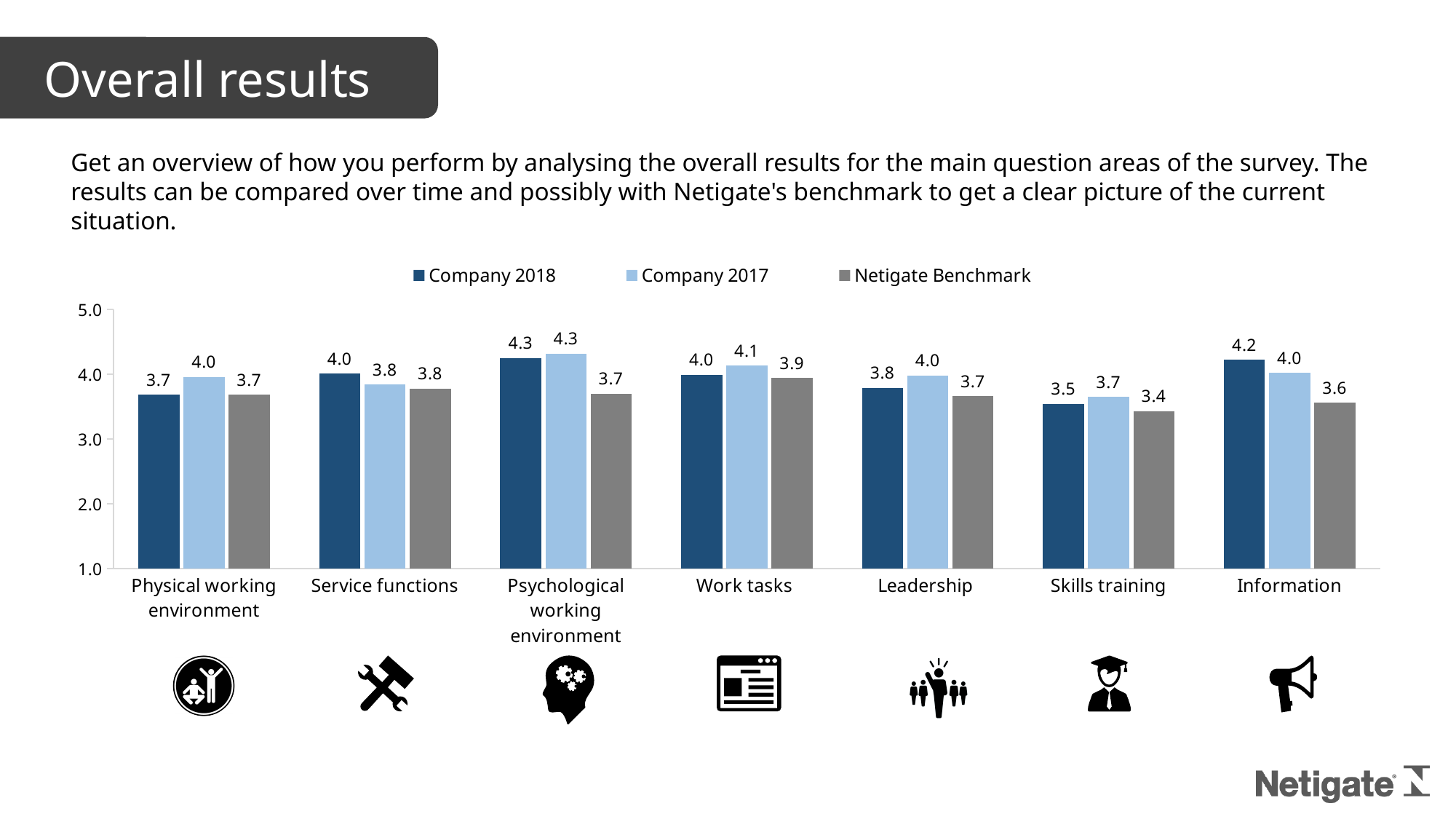
Which category has the lowest Company 2018 value? Skills training How many categories are shown on the x axis? 7 Which category has the lowest Netigate Benchmark value? Skills training For Information, which is larger: the Company 2018 value or the Company 2017 value? Company 2018 What is the Company 2018 value for Psychological working environment? 4.3 What kind of chart is shown on the slide? bar chart Is the Company 2017 value for Skills training greater or less than 4.0? less What is the Company 2017 value for Work tasks? 4.1 What is the difference between the Company 2018 value and the Netigate Benchmark value for Information? 0.6 How many series does the legend list? 3 Which category has the highest Company 2018 value? Psychological working environment What is the Netigate Benchmark value for Skills training? 3.4